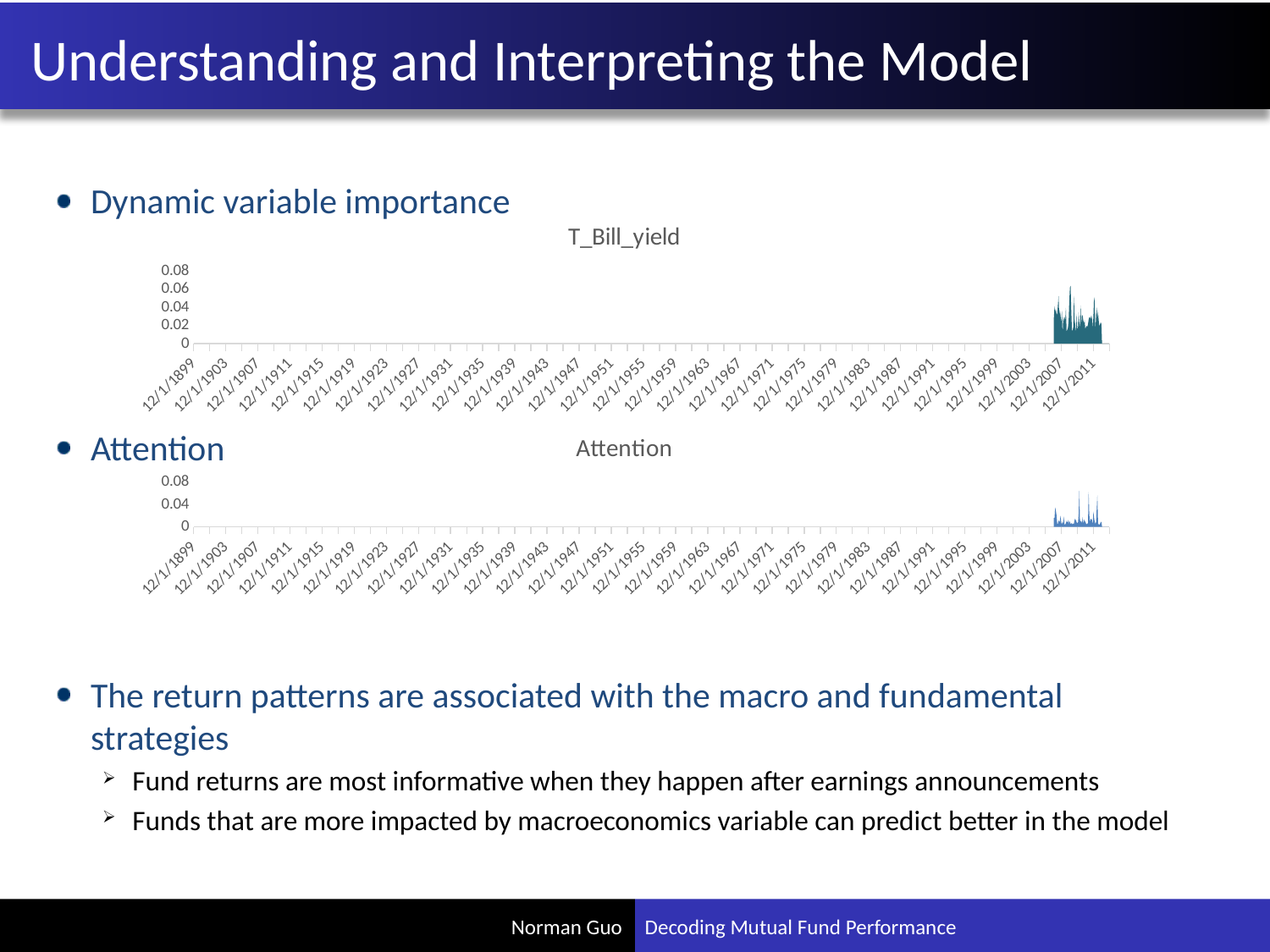
In the Attention chart, is the highest spike after 12/1/2007 greater or less than 0.04? greater In the T_Bill_yield chart, what is the last date label on the x axis? 12/1/2011 What is the title of the lower chart on the slide? Attention In the Attention chart, what is the first date label on the x axis? 12/1/1899 In the T_Bill_yield chart, what is the highest value shown on the y axis? 0.08 In the T_Bill_yield chart, are the values near the end of the x axis (after 2007) higher or lower than the values in the early 1900s? higher How many charts are shown on the slide? 2 What is the title of the upper chart on the slide? T_Bill_yield In the Attention chart, do the values stay near zero or rise over most of the period from 1899 to 2003? stay near zero In the T_Bill_yield chart, is the peak value reached after 12/1/2007 greater or less than 0.04? greater